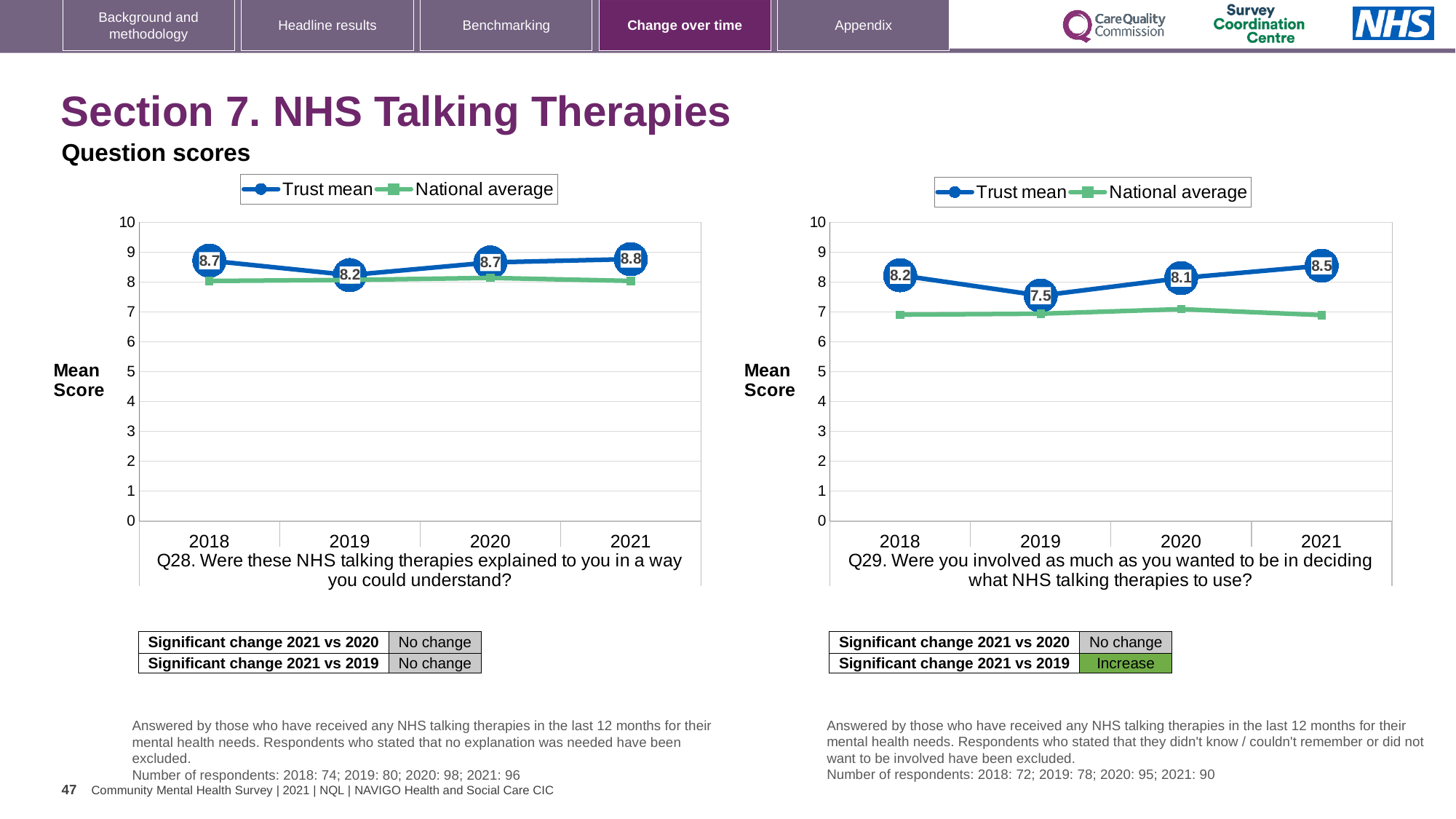
In the Q29 chart (right), what is the Trust mean score for 2021? 8.5 In the Q29 chart (right), which year has the lowest Trust mean score? 2019 What type of chart is used for Q28 (left)? Line chart In the Q29 chart (right), is the National average for 2018 greater or less than 8? less In the Q29 chart (right), which year has the highest Trust mean score? 2021 How many years are plotted on the x axis of the Q28 chart (left)? 4 In the Q28 chart (left), is the Trust mean for 2021 higher or lower than the Trust mean for 2019? higher In the Q28 chart (left), what is the Trust mean score for 2019? 8.2 In the Q29 chart (right), what is the Trust mean score for 2019? 7.5 In the Q29 chart (right), what is the difference between the Trust mean scores for 2021 and 2019? 1.0 How many series does the legend of the Q29 chart (right) list? 2 In the Q28 chart (left), what is the Trust mean score for 2021? 8.8